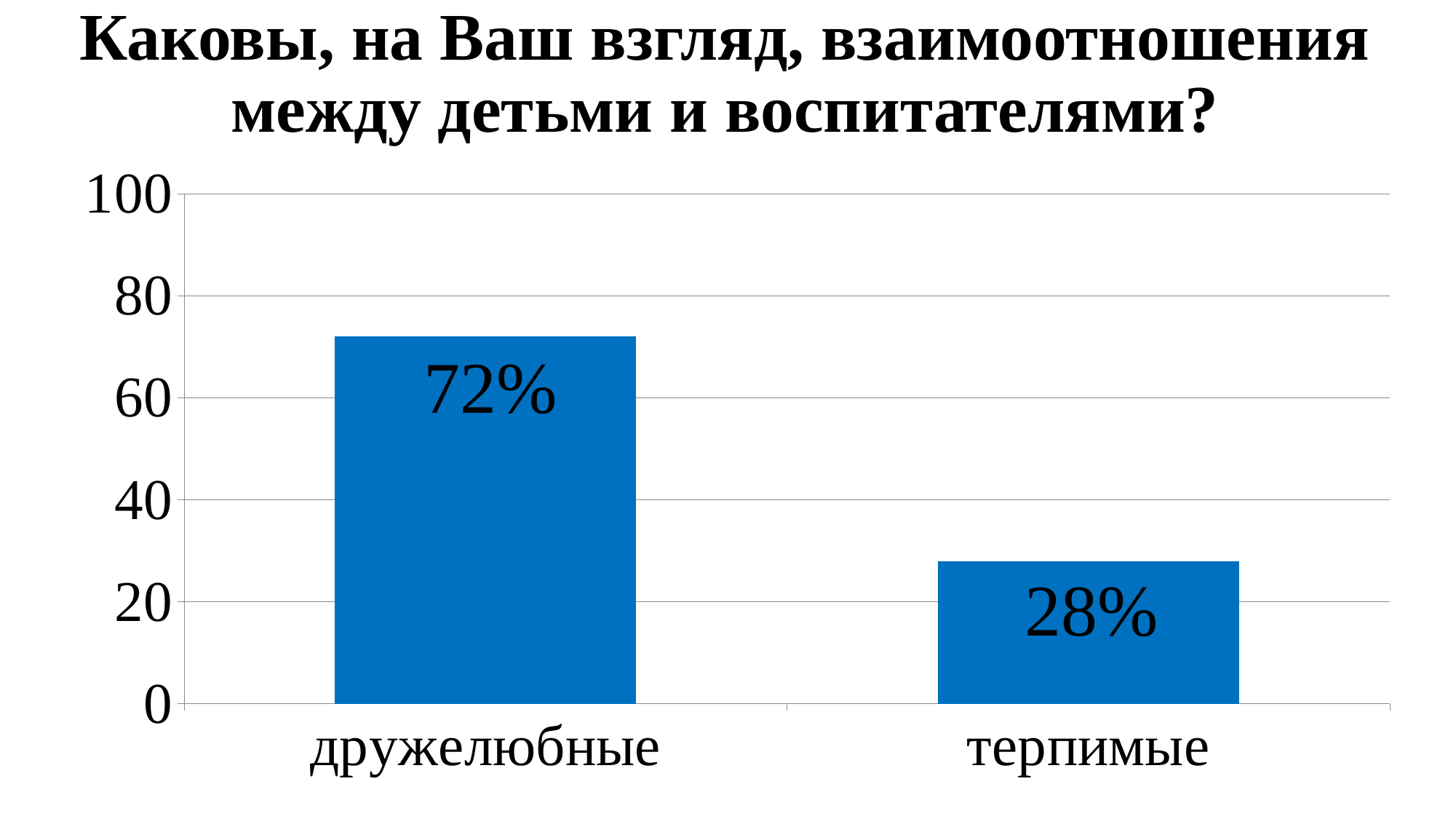
What is the title of the chart? Каковы, на Ваш взгляд, взаимоотношения между детьми и воспитателями? What is the difference between the values for дружелюбные and терпимые? 44% Which category has the highest value? дружелюбные Which is larger, the value for дружелюбные or the value for терпимые? дружелюбные What kind of chart is shown on the slide? bar chart What is the value for дружелюбные? 72% What is the value for терпимые? 28% How many categories are shown on the chart? 2 What is the highest value shown on the vertical axis? 100 Is the value for дружелюбные greater or less than 60? greater Which category has the lowest value? терпимые Is the value for терпимые greater or less than 40? less